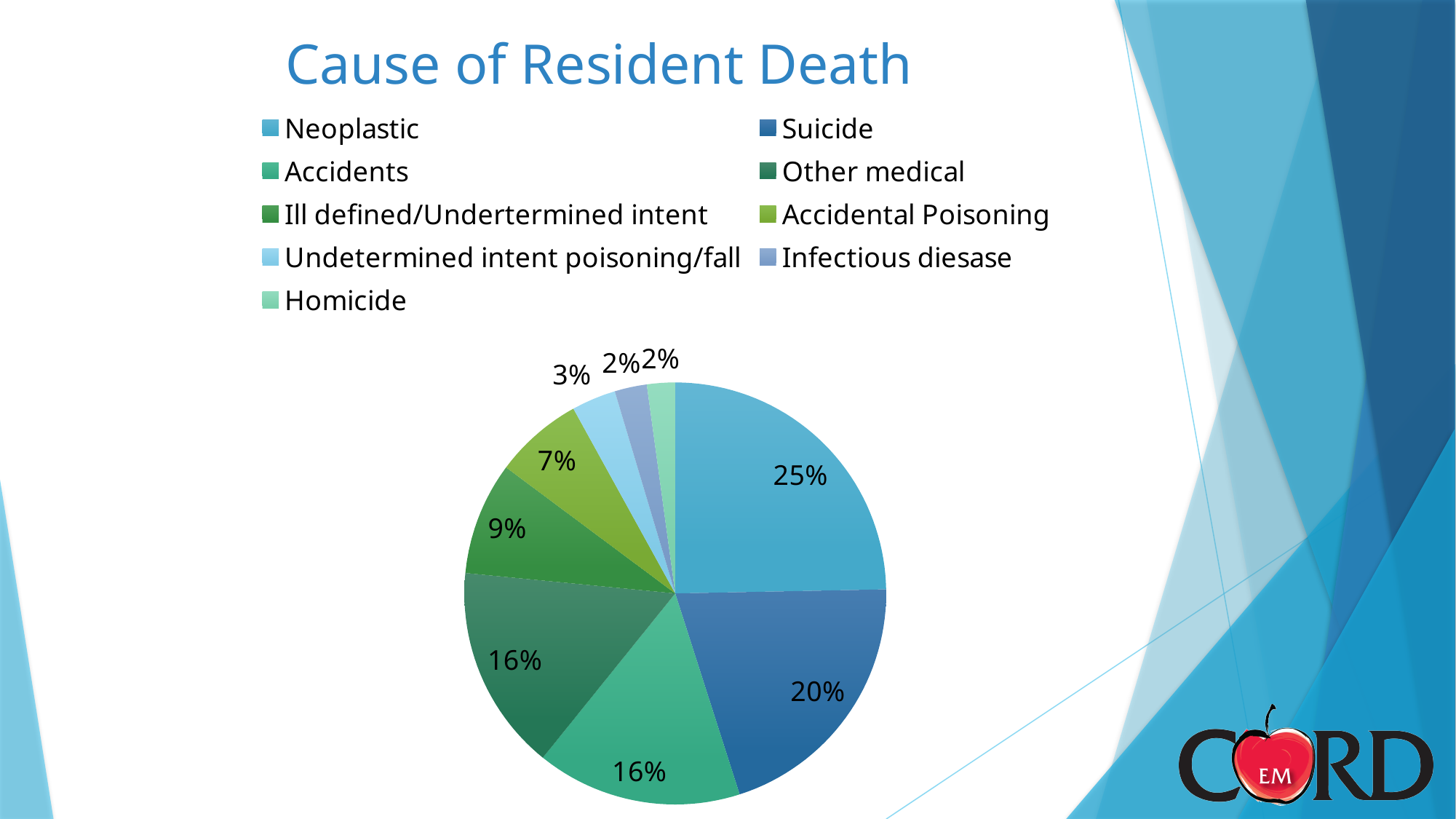
How many categories (slices) does the pie chart have? 9 What percentage of resident deaths is attributed to Suicide? 20% What type of chart is shown on the slide? Pie chart What percentage of resident deaths is attributed to Ill defined/Undetermined intent? 9% What is the title of the chart? Cause of Resident Death What percentage of resident deaths is attributed to Undetermined intent poisoning/fall? 3% Which is larger, the share for Suicide or the share for Accidents? Suicide What share of resident deaths is attributed to Neoplastic causes? 25% How many entries does the legend list? 9 What is the difference in percentage points between the Neoplastic share and the Suicide share? 5 percentage points Which cause of resident death has the largest share of the pie? Neoplastic What percentage of resident deaths is attributed to Accidental Poisoning? 7%